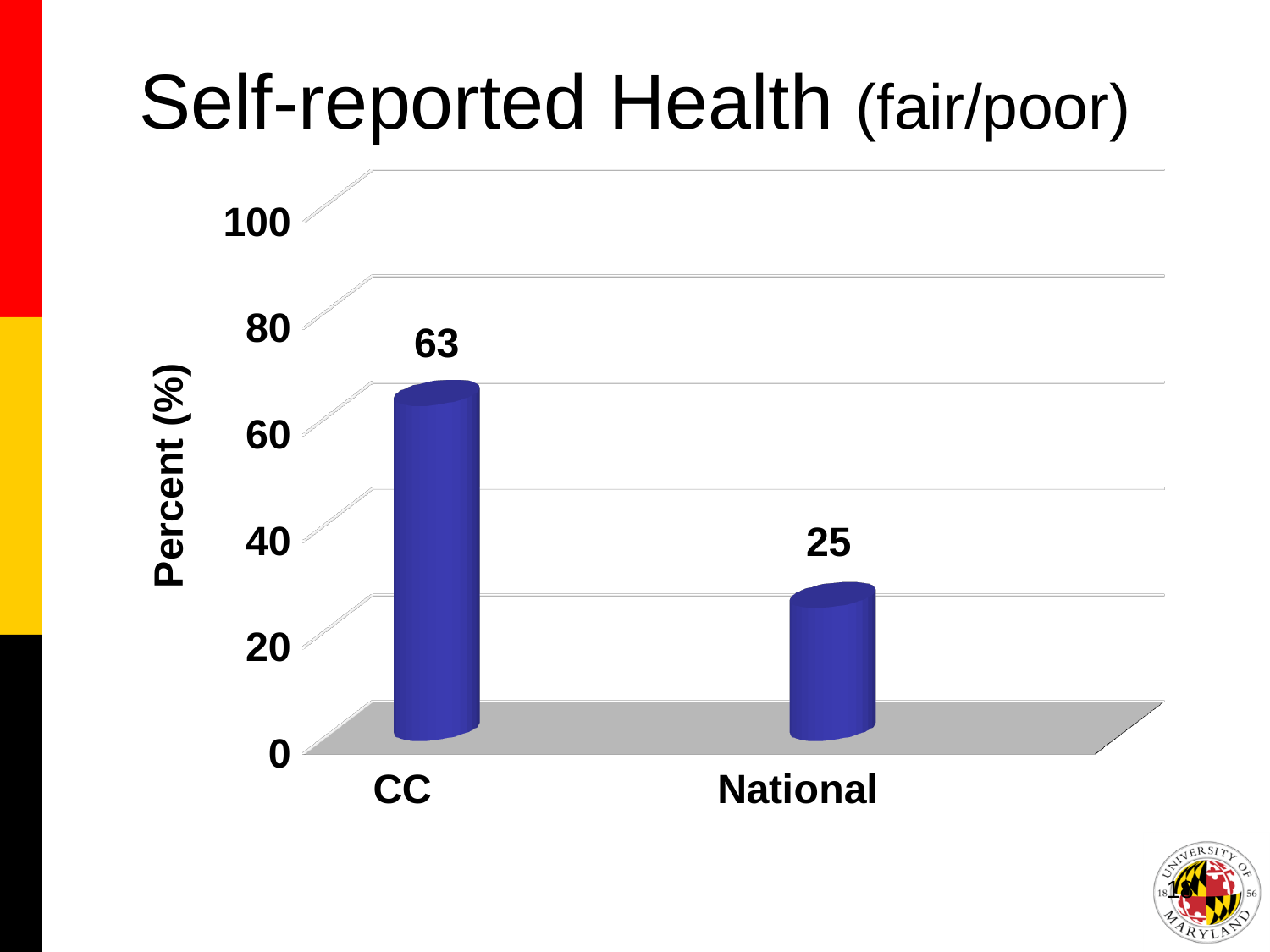
Which category has the lowest value? National How many categories are shown on the x axis? 2 What is the value for CC? 63 What kind of chart is shown on the slide? bar chart What is the title of the slide? Self-reported Health (fair/poor) What is the value for National? 25 Is the value for CC greater or less than 60? greater Which category has the highest value? CC Which is larger, the value for CC or the value for National? CC What is the difference between the values for CC and National? 38 Is the value for National greater or less than 40? less What is the label of the y axis? Percent (%)